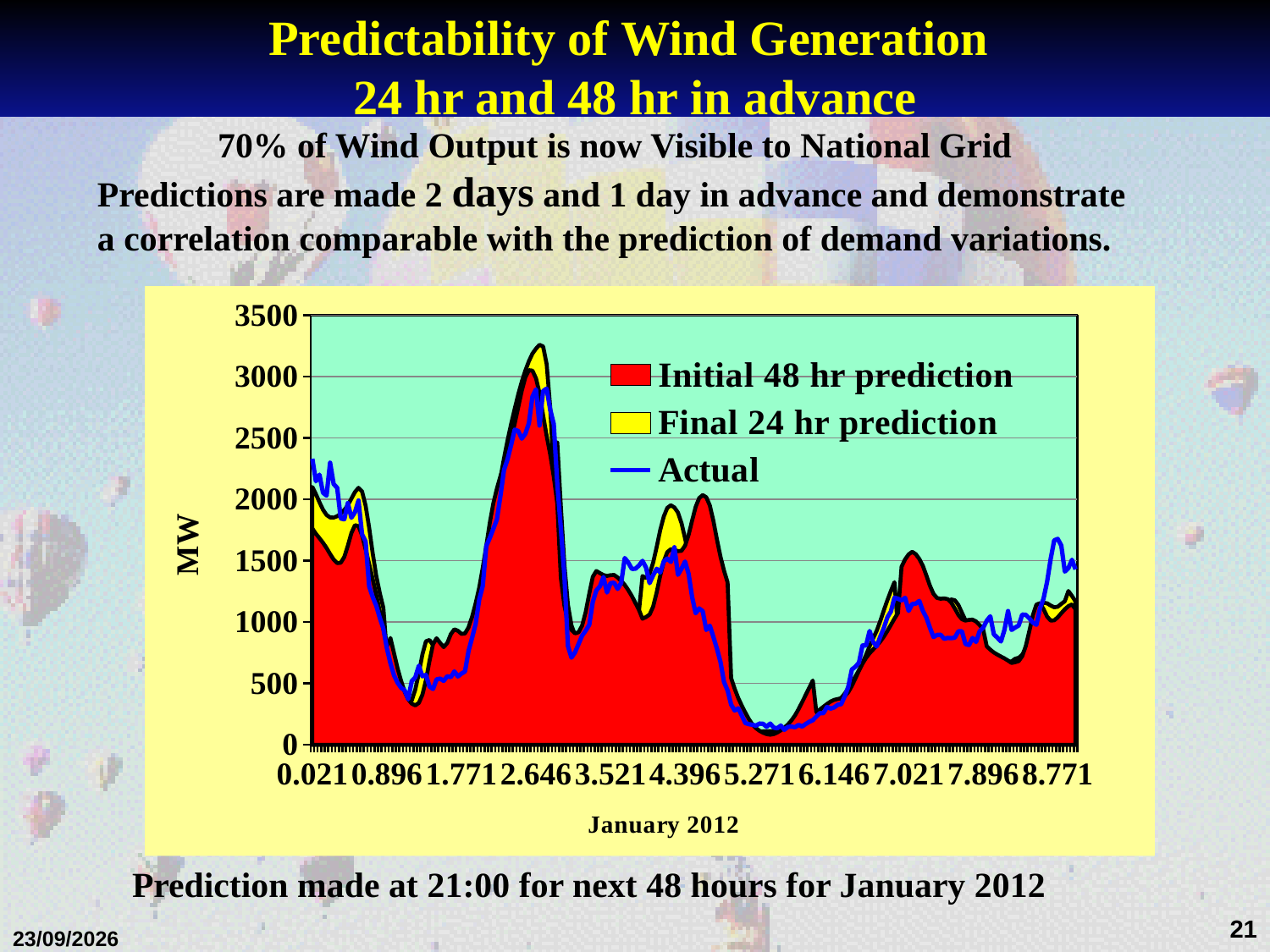
What is the title of the y axis of the chart? MW What kind of chart is shown on the slide? area and line chart Is the peak of the Final 24 hr prediction area near x = 2.646 greater or less than 3000? greater Is the Actual value at x = 5.271 greater or less than 500? less Is the Actual value at x = 8.771 greater or less than 1000? greater What colour is used for the Final 24 hr prediction series in the chart? yellow How many series does the chart legend list? 3 How many tick labels are shown on the x axis of the chart? 11